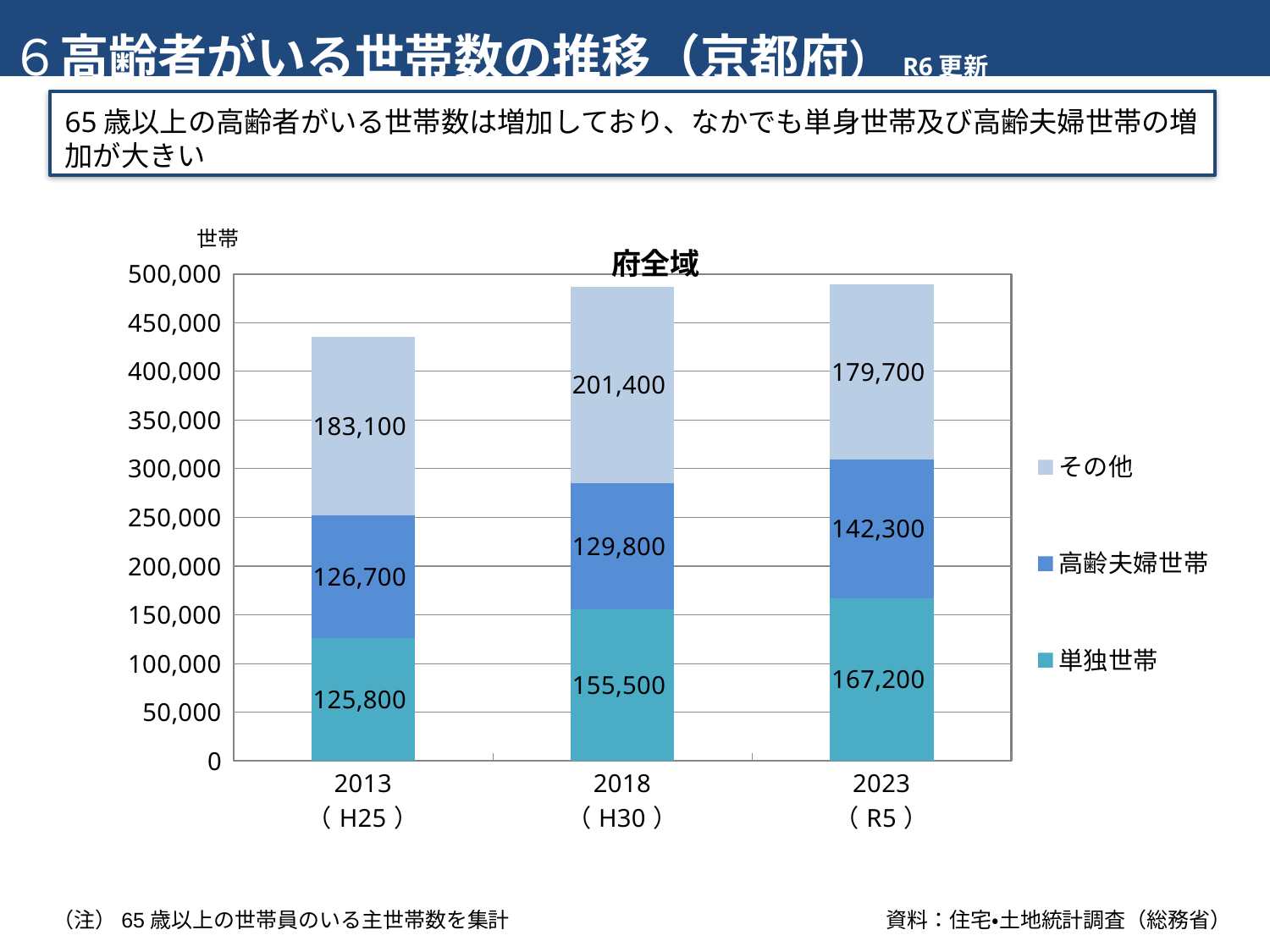
What is the value for その他 in 2018 (H30)? 201,400 How many series does the legend list? 3 What is the value for 単独世帯 in 2013 (H25)? 125,800 In which year is the 単独世帯 value the highest? 2023 (R5) What is the difference between the 単独世帯 value in 2023 (R5) and in 2013 (H25)? 41,400 Is the total height of the 2013 (H25) stacked bar greater or less than 450,000? less How many years are shown on the x axis? 3 What kind of chart is shown? Stacked bar chart Which is larger: その他 in 2018 (H30) or その他 in 2023 (R5)? その他 in 2018 (H30) What is the value for 高齢夫婦世帯 in 2023 (R5)? 142,300 What is the total of the stacked bar for 2018 (H30)? 486,700 In which year is the 高齢夫婦世帯 value the lowest? 2013 (H25)